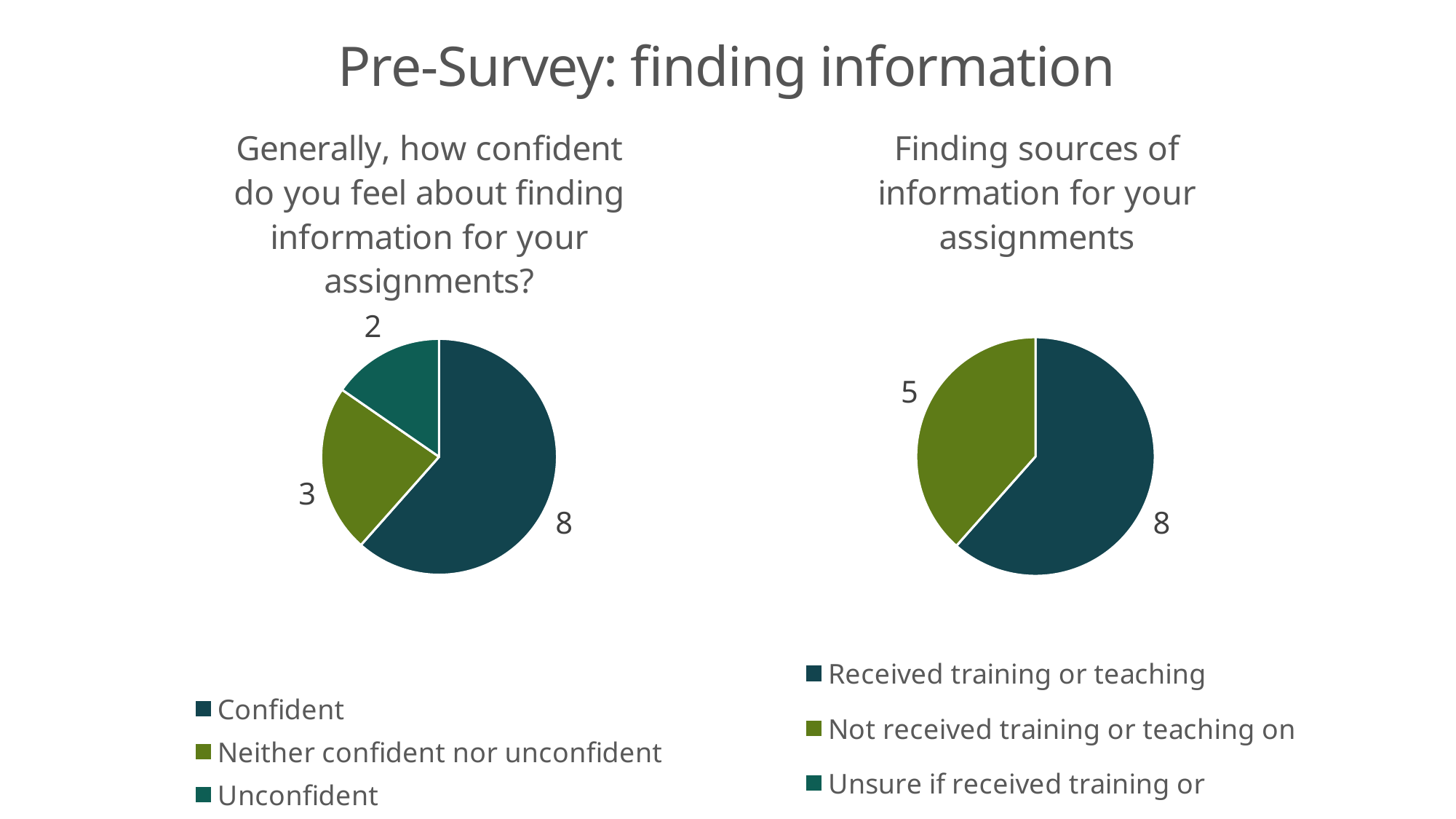
In the left chart, 'Generally, how confident do you feel about finding information for your assignments?', which category has the largest slice? Confident In the left chart, 'Generally, how confident do you feel about finding information for your assignments?', what is the value for Confident? 8 In the left chart, 'Generally, how confident do you feel about finding information for your assignments?', what is the value for Unconfident? 2 How many entries does the legend of the right chart, 'Finding sources of information for your assignments', list? 3 In the right chart, 'Finding sources of information for your assignments', which is larger: Received training or teaching, or Not received training or teaching on? Received training or teaching In the right chart, 'Finding sources of information for your assignments', what is the value for Not received training or teaching on? 5 In the left chart, 'Generally, how confident do you feel about finding information for your assignments?', what is the difference between the Confident and Unconfident values? 6 In the right chart, 'Finding sources of information for your assignments', what is the difference between Received training or teaching and Not received training or teaching on? 3 In the left chart, 'Generally, how confident do you feel about finding information for your assignments?', what is the value for Neither confident nor unconfident? 3 What kind of chart is the left chart, 'Generally, how confident do you feel about finding information for your assignments?'? Pie chart In the right chart, 'Finding sources of information for your assignments', what is the value for Received training or teaching? 8 In the left chart, 'Generally, how confident do you feel about finding information for your assignments?', which category has the smallest slice? Unconfident